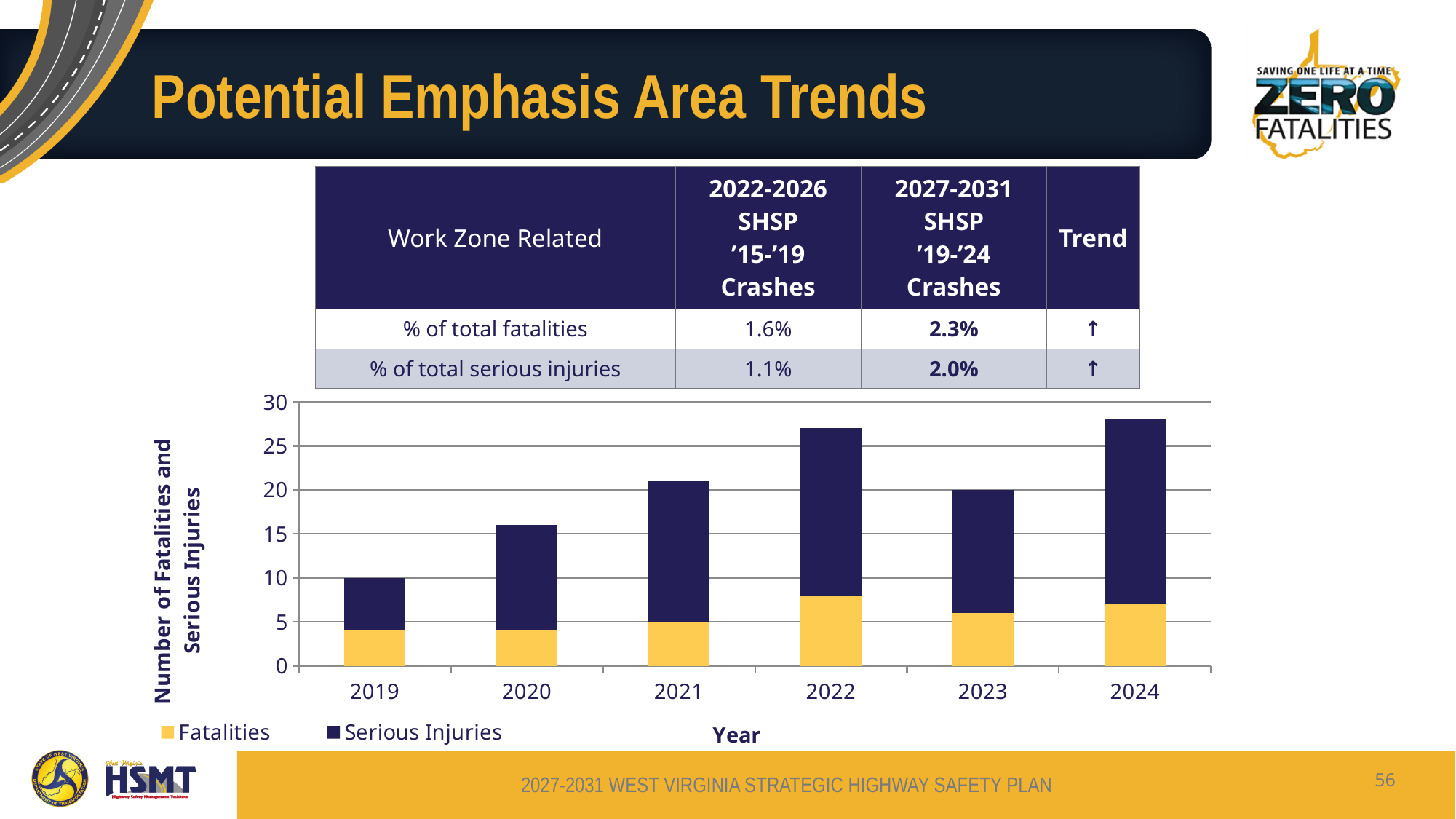
Do the total bars generally rise or fall from 2019 to 2024? Rise What kind of chart is shown on the slide? Stacked bar chart Is the total for 2021 greater or less than 20? greater Is the number of fatalities in 2019 greater or less than 5? less Which year has a larger total of fatalities and serious injuries, 2022 or 2023? 2022 Which year has the lowest total of fatalities and serious injuries? 2019 What is the total number of fatalities and serious injuries for 2019? 10 What is the title of the chart's y axis? Number of Fatalities and Serious Injuries How many series does the chart legend list? 2 What is the total number of fatalities and serious injuries for 2023? 20 How many years are shown on the x axis of the chart? 6 Is the total for 2022 greater or less than 25? greater